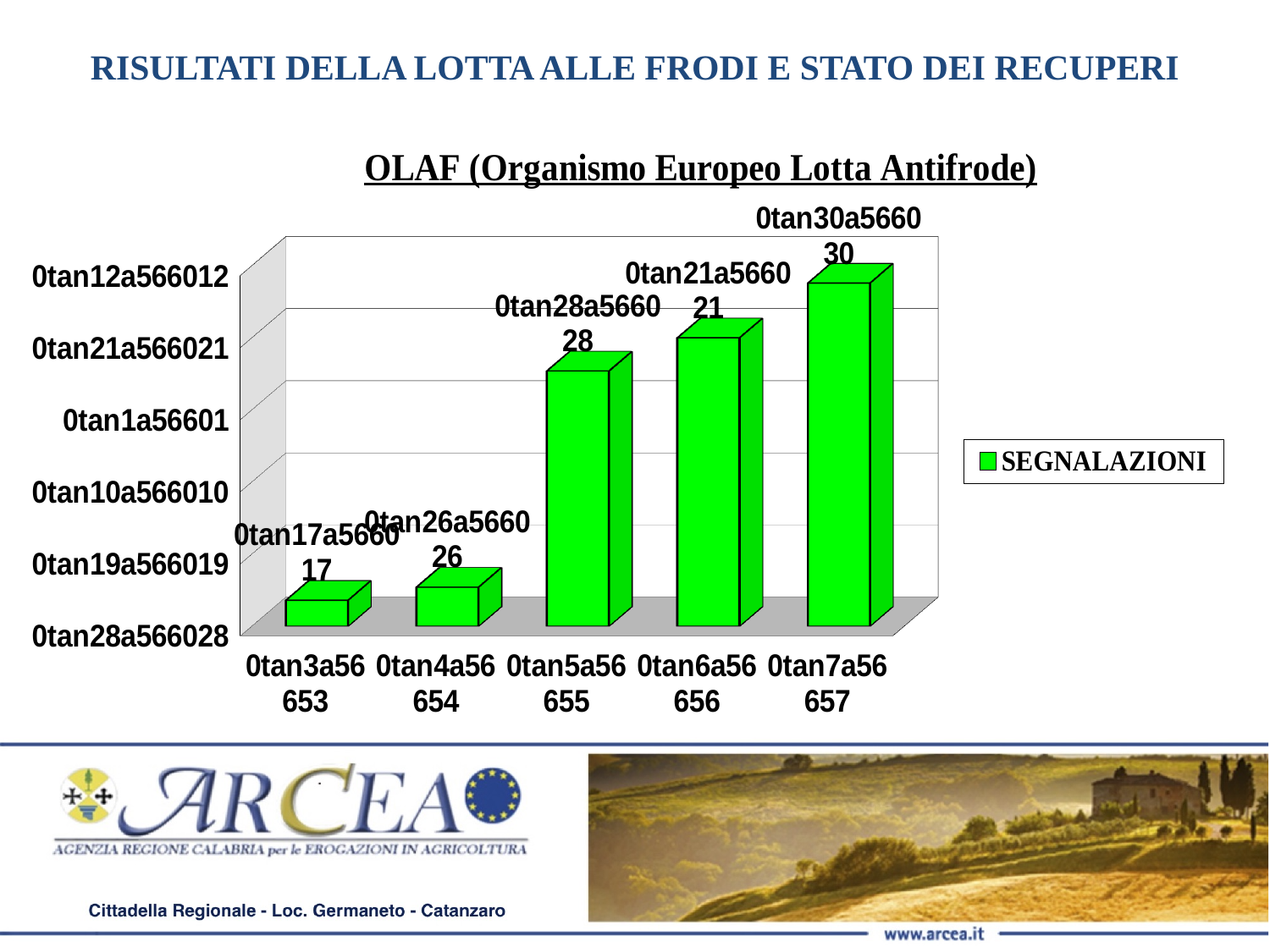
What kind of chart is shown on the slide? bar chart Which is taller, the fourth bar or the fifth bar from the left? the fifth bar Which bar is the shortest in the chart, by position from left to right? the first (leftmost) bar What is the title of the chart? OLAF (Organismo Europeo Lotta Antifrode) How many series does the chart legend list? 1 Which is taller, the second bar or the third bar from the left? the third bar Which is taller, the first bar or the second bar from the left? the second bar What is the name of the series shown in the chart legend? SEGNALAZIONI Do the bar values rise or fall from left to right along the x axis? rise How many bars are plotted in the chart? 5 Which bar is the tallest in the chart, by position from left to right? the fifth (rightmost) bar